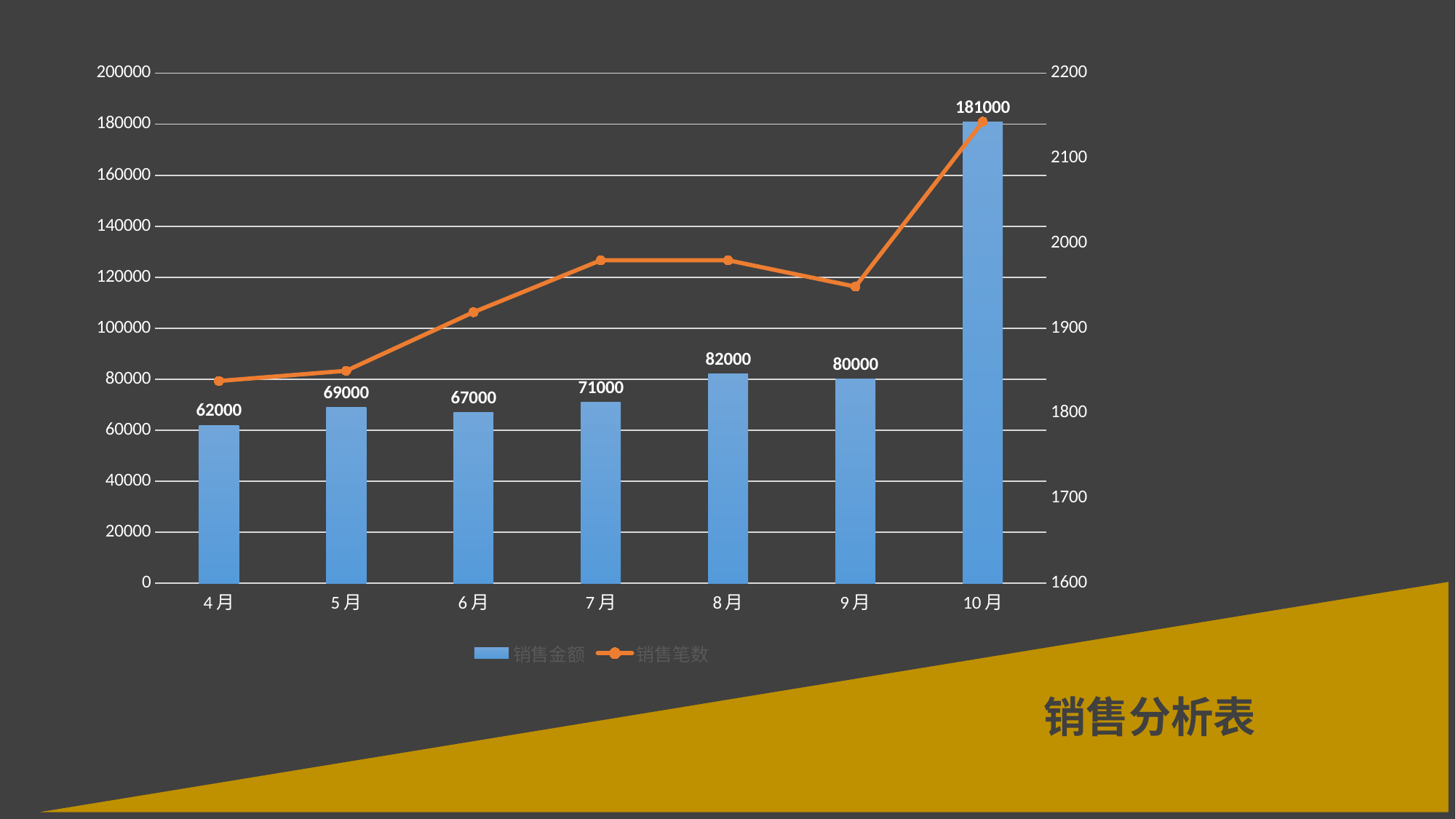
What is the 销售金额 value for 8月? 82000 Which month has the highest 销售金额? 10月 What is the 销售金额 value for 10月? 181000 What is the difference in 销售金额 between 10月 and 9月? 101000 How many months are shown on the x axis? 7 Which month has the larger 销售金额, 5月 or 6月? 5月 How many series does the legend list? 2 Which series is drawn as a line in the chart? 销售笔数 Is the 销售笔数 value for 4月 greater or less than 1900? less What kind of chart is shown on the slide? Combined bar and line chart Is the 销售笔数 value for 10月 greater or less than 2100? greater Which month has the lowest 销售金额? 4月